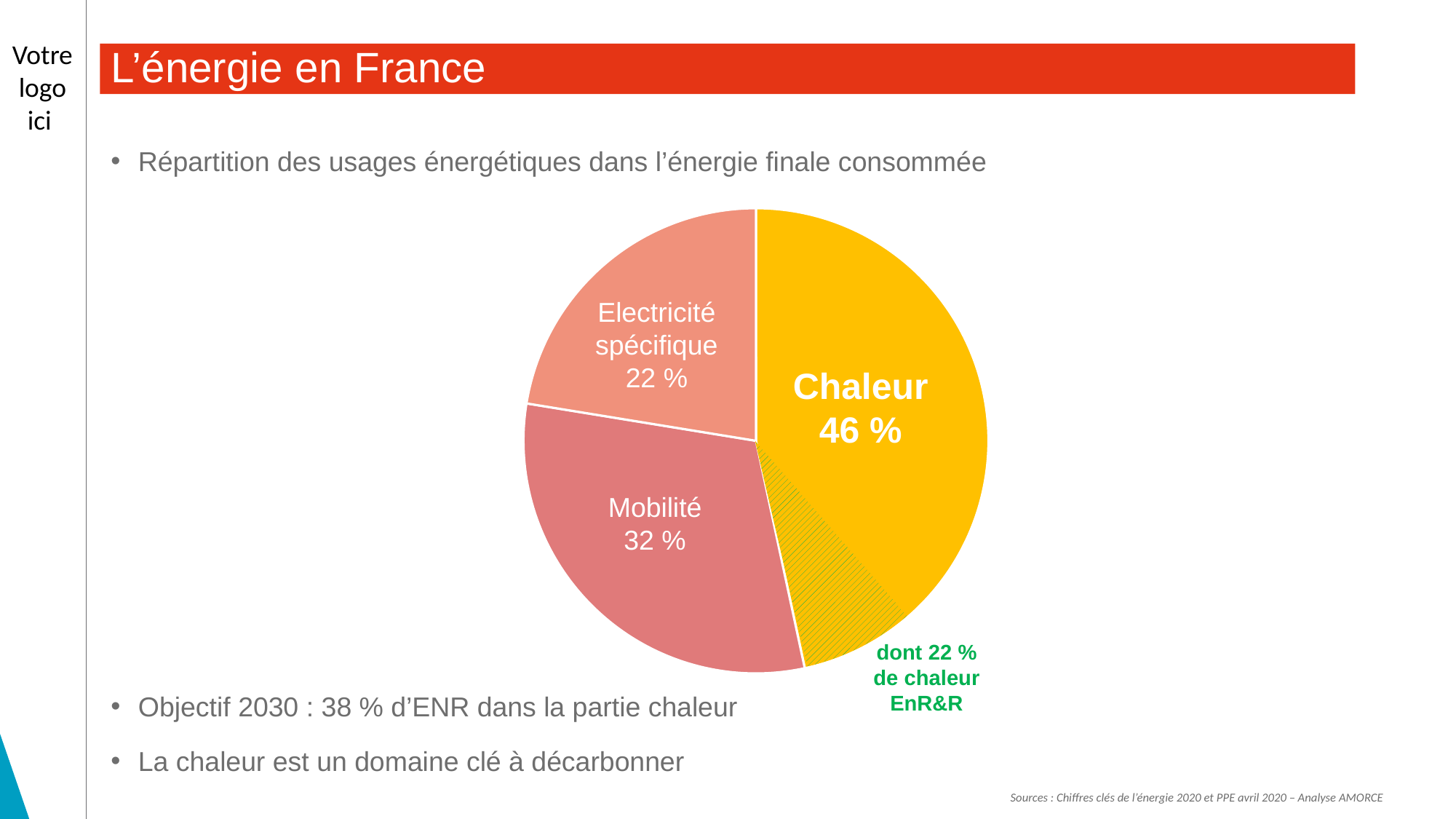
What colour is the Chaleur slice? yellow Which is larger, the Mobilité slice or the Electricité spécifique slice? Mobilité What is the difference in percentage points between Mobilité and Electricité spécifique? 10 What share of final energy consumption does Mobilité represent? 32 % What kind of chart is shown on the slide? pie chart Which slice of the pie chart is the largest? Chaleur According to the hatched portion of the Chaleur slice, what share of heat comes from EnR&R? 22 % Which slice of the pie chart is the smallest? Electricité spécifique What share of final energy consumption does Chaleur represent? 46 % How many slices does the pie chart have? 3 What is the difference in percentage points between Chaleur and Mobilité? 14 What share of final energy consumption does Electricité spécifique represent? 22 %